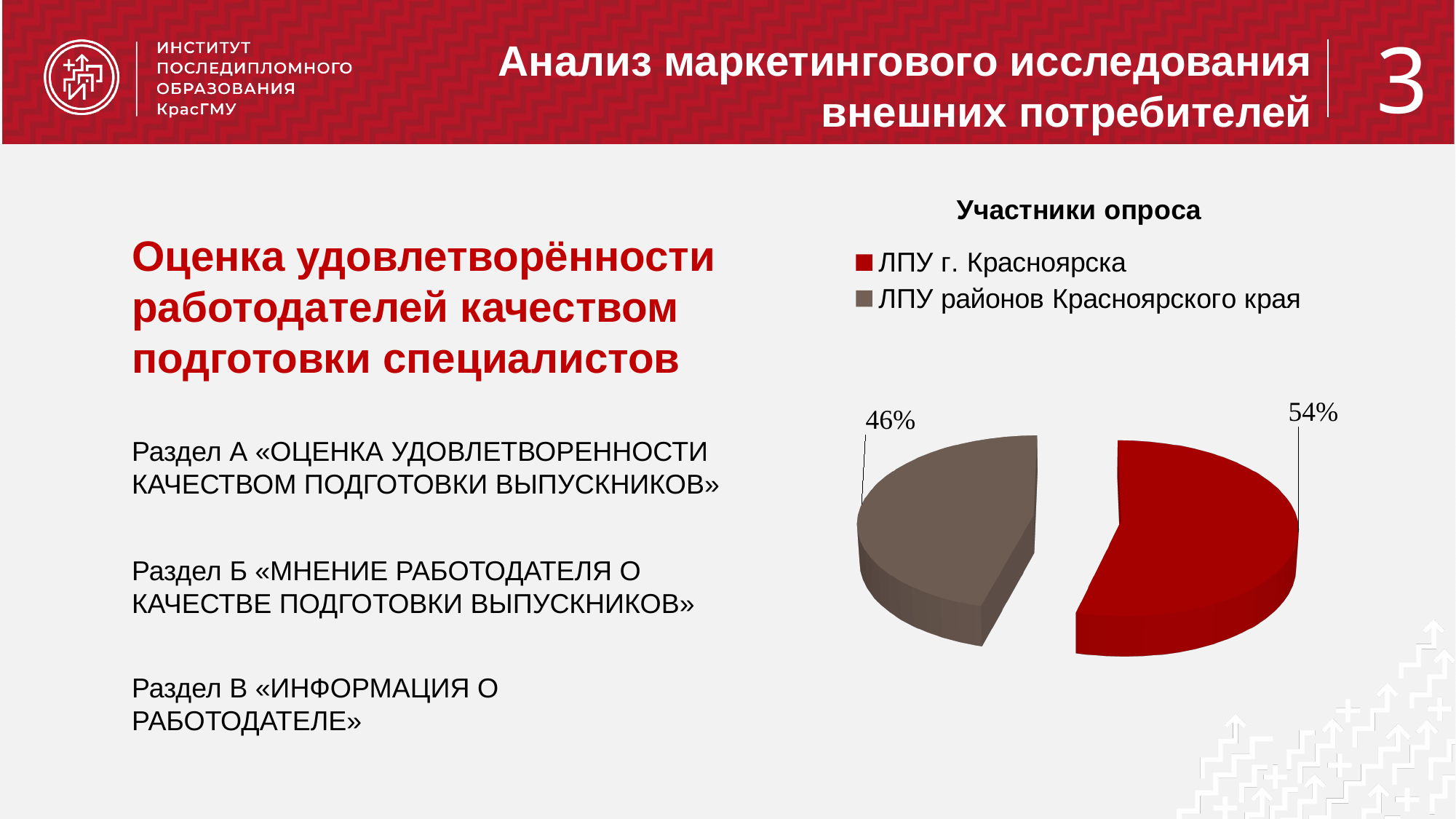
What is the title of the chart? Участники опроса What share of the pie does ЛПУ районов Красноярского края hold? 46% What share of the pie does ЛПУ г. Красноярска hold? 54% What is the difference in percentage points between the ЛПУ г. Красноярска slice and the ЛПУ районов Красноярского края slice? 8 Which colour represents ЛПУ г. Красноярска in the pie chart? red How many slices does the pie chart have? 2 Is the share for ЛПУ г. Красноярска greater or less than 50%? greater Which category has the largest slice of the pie? ЛПУ г. Красноярска Which category has the smallest slice of the pie? ЛПУ районов Красноярского края Is the share for ЛПУ районов Красноярского края greater or less than 50%? less What kind of chart is shown on the slide? pie chart Which is larger: the share for ЛПУ г. Красноярска or the share for ЛПУ районов Красноярского края? ЛПУ г. Красноярска